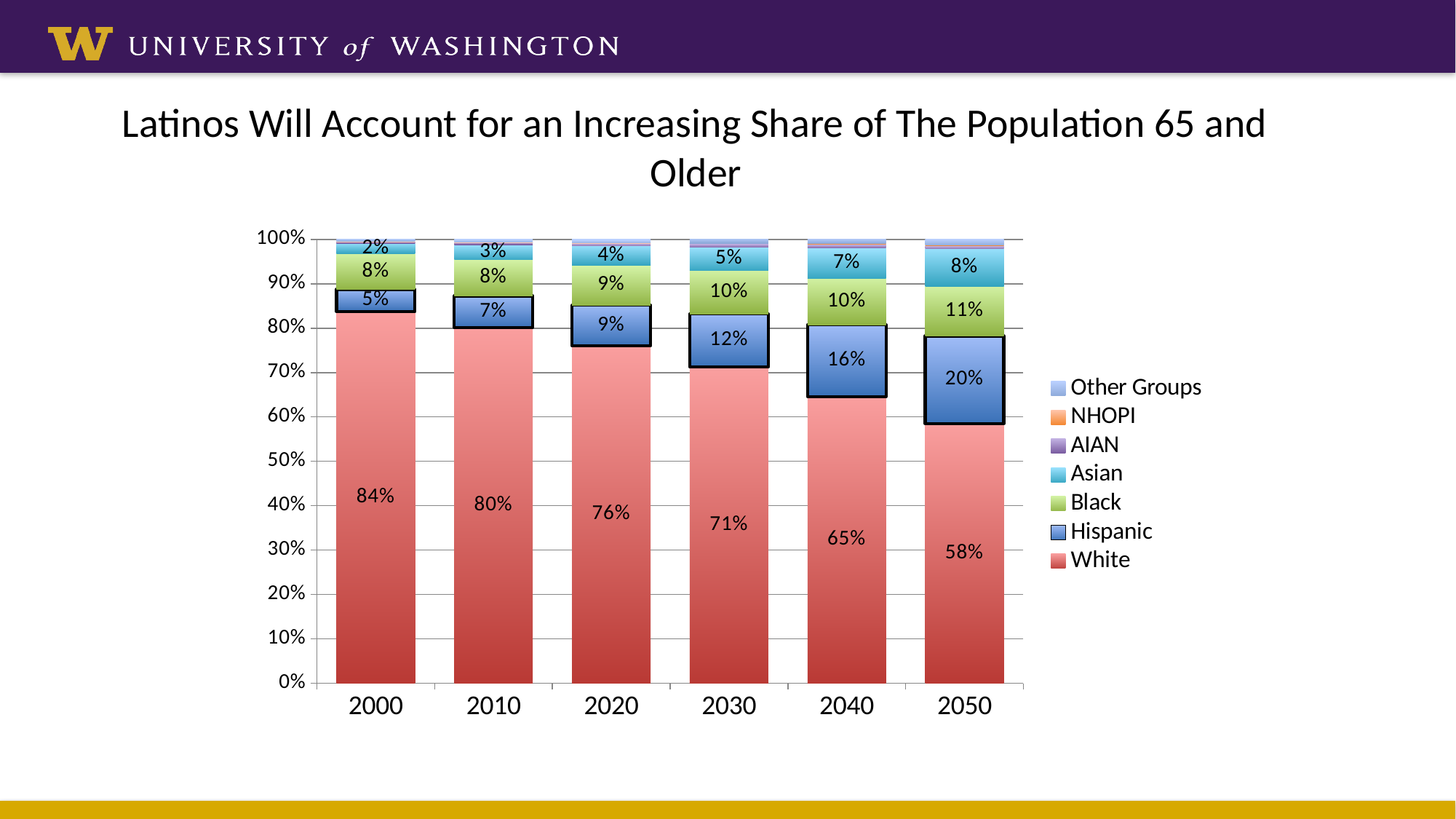
Which is larger in 2020: the Black share or the Asian share? Black In which year is the Hispanic share the highest? 2050 Does the Hispanic share rise or fall from 2000 to 2050? rise What is the Hispanic share of the population 65 and older in 2050? 20% What kind of chart is shown on the slide? stacked bar chart In which year is the White share the lowest? 2050 How many series does the legend list? 7 How much larger is the Hispanic share in 2050 than in 2000? 15% What is the Black share in 2030? 10% How many years are shown on the x axis? 6 What is the White share of the population 65 and older in 2000? 84% What is the Asian share in 2040? 7%